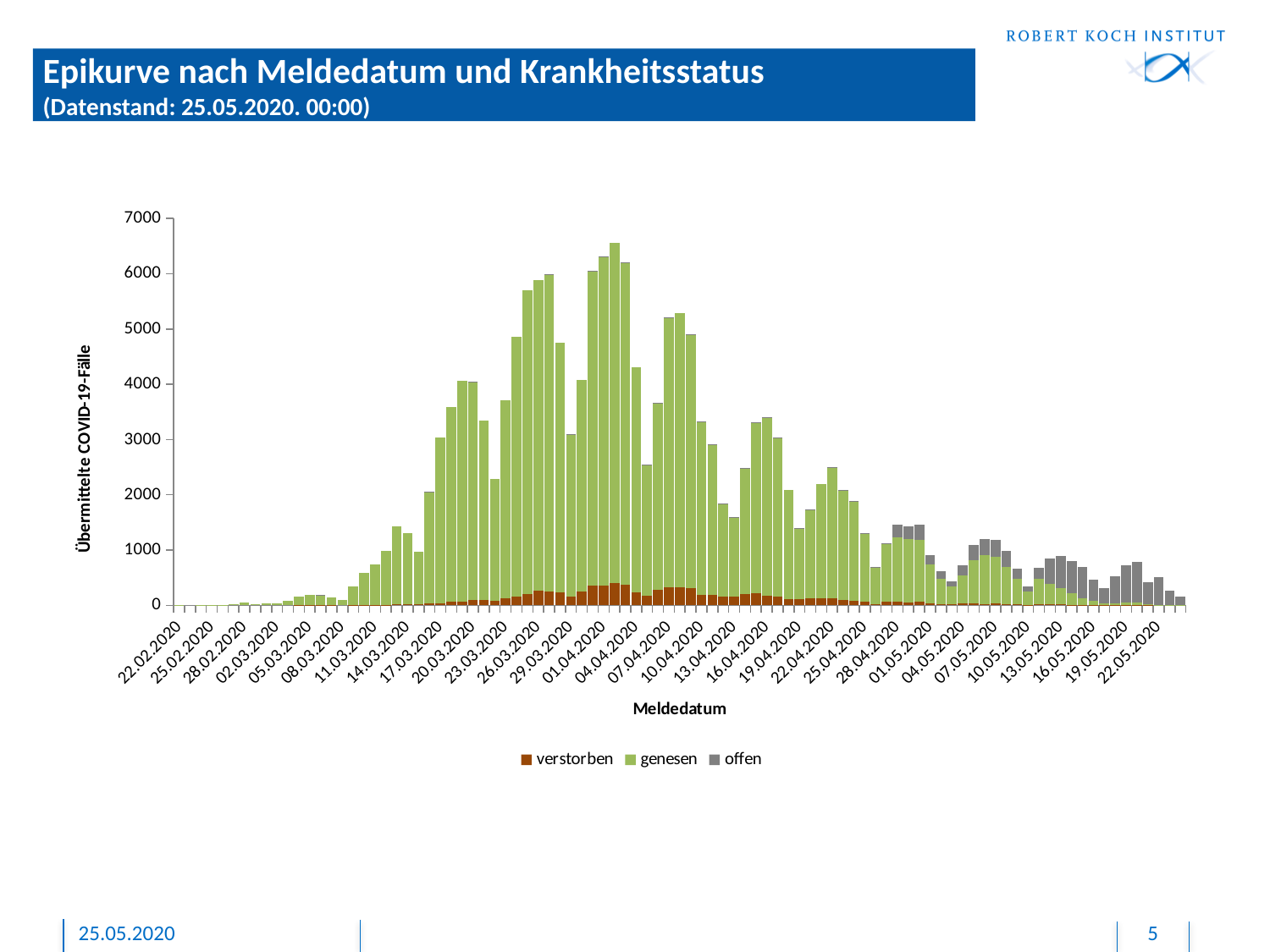
Is the total value for 13.04.2020 greater or less than 3000? less How many series does the legend list? 3 What is the title of the y axis? Übermittelte COVID-19-Fälle What kind of chart is shown on the slide? stacked bar chart Do the total values generally rise or fall along the x axis from 01.04.2020 to 22.05.2020? fall Is the total value for 22.05.2020 greater or less than 1000? less What are the three series named in the legend? verstorben, genesen, offen Is the total value for 01.04.2020 greater or less than 6000? greater Which has the larger total bar, 26.03.2020 or 13.04.2020? 26.03.2020 Do the total values generally rise or fall along the x axis from 22.02.2020 to 01.04.2020? rise